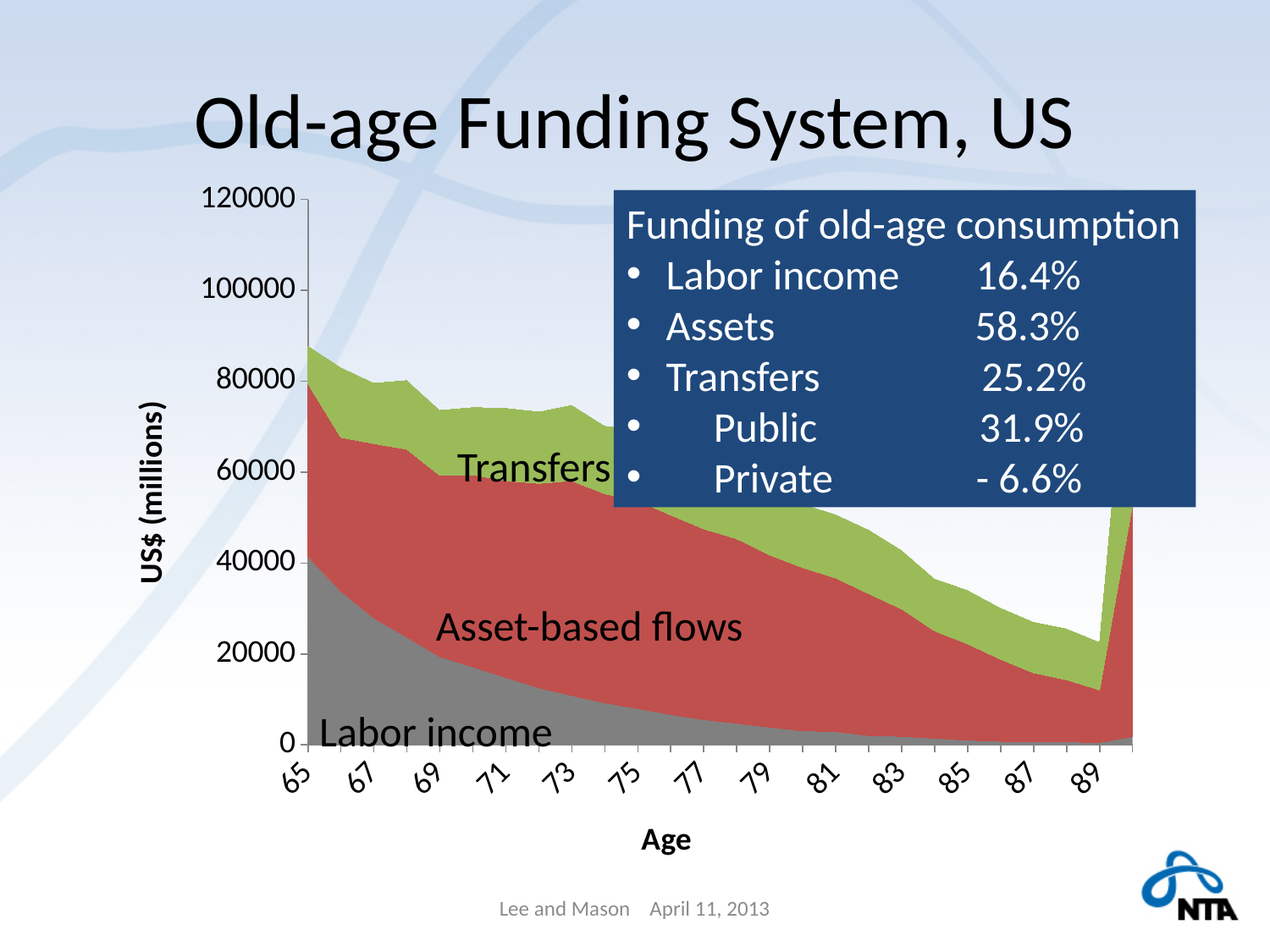
What is the title of the vertical axis of the chart? US$ (millions) Is the total of all three series at age 89 greater or less than 40000? less How many series are plotted in the chart? 3 Which series is the largest at age 75? Asset-based flows Is the total of all three series at age 65 greater or less than 80000? greater What is the title of the horizontal axis of the chart? Age What kind of chart is shown on the slide? Stacked area chart Which is larger at age 65: labor income or asset-based flows? Labor income Is the value of labor income at age 85 greater or less than 20000? less How many age labels are shown on the horizontal axis? 13 Does labor income rise or fall as age increases from 65 to 89? Fall Which series is the smallest at age 85? Labor income